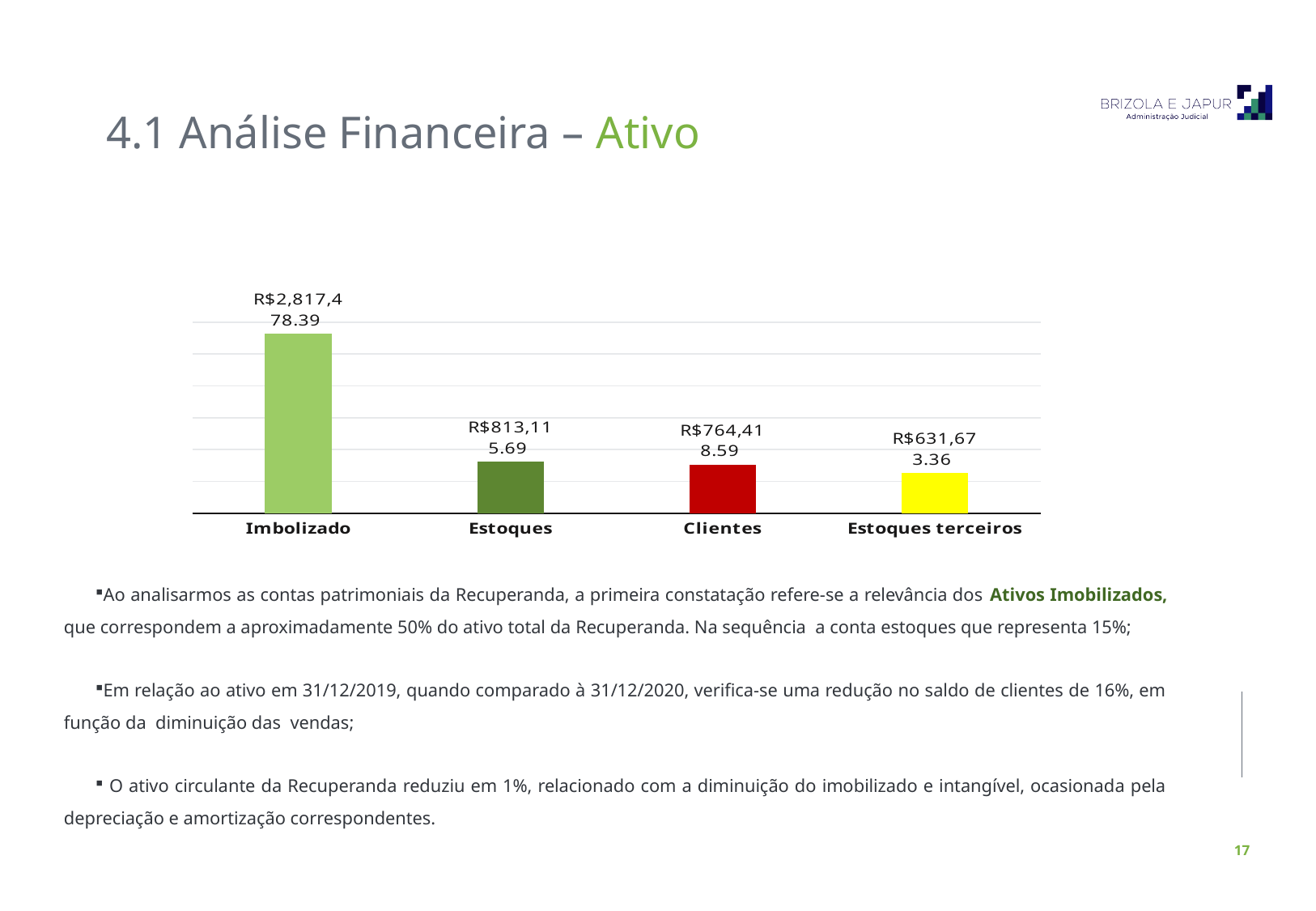
What is the difference between the values for Estoques and Clientes? R$48,697.10 Which category has the lowest value? Estoques terceiros Do the values rise or fall from left to right across the categories? Fall What is the value shown for Estoques terceiros? R$631,673.36 Which is larger, the value for Estoques or the value for Clientes? Estoques How many categories are shown in the chart? 4 What is the value shown for Imbolizado? R$2,817,478.39 What is the difference between the values for Clientes and Estoques terceiros? R$132,745.23 What is the value shown for Estoques? R$813,115.69 What kind of chart is shown on the slide? Bar chart What is the value shown for Clientes? R$764,418.59 Which category has the highest value? Imbolizado